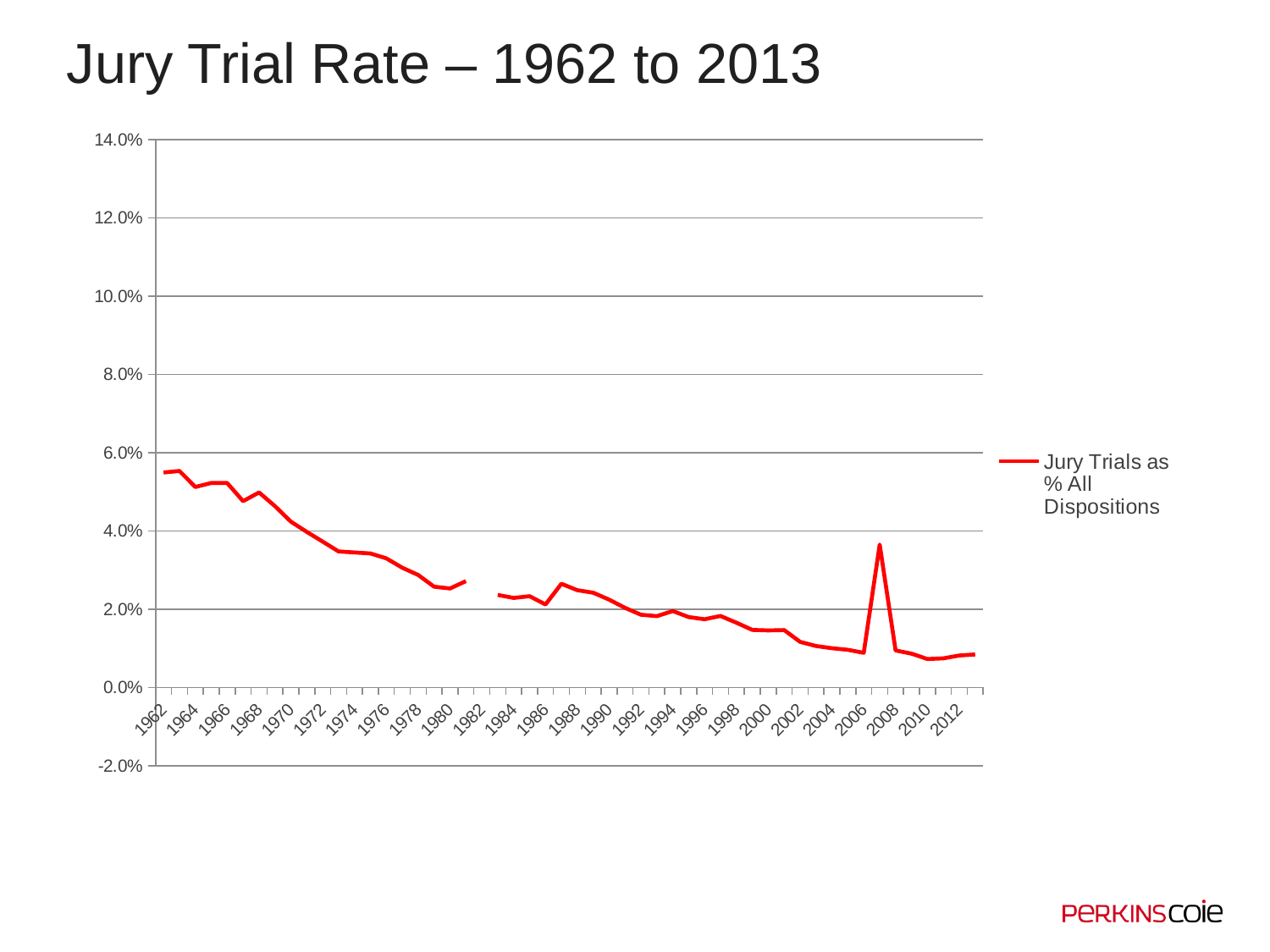
How many series does the legend list? 1 Is the value for 1972 greater or less than 4.0%? less Is the value for 2000 greater or less than 2.0%? less What is the legend entry for the plotted series? Jury Trials as % All Dispositions Which year has the larger value, 1962 or 2012? 1962 Is the value for 1962 greater or less than 4.0%? greater Which year has the larger value, 1970 or 1990? 1970 Overall, do the values rise or fall from 1962 to 2013? fall What kind of chart is shown on the slide? line chart What is the title of the chart? Jury Trial Rate – 1962 to 2013